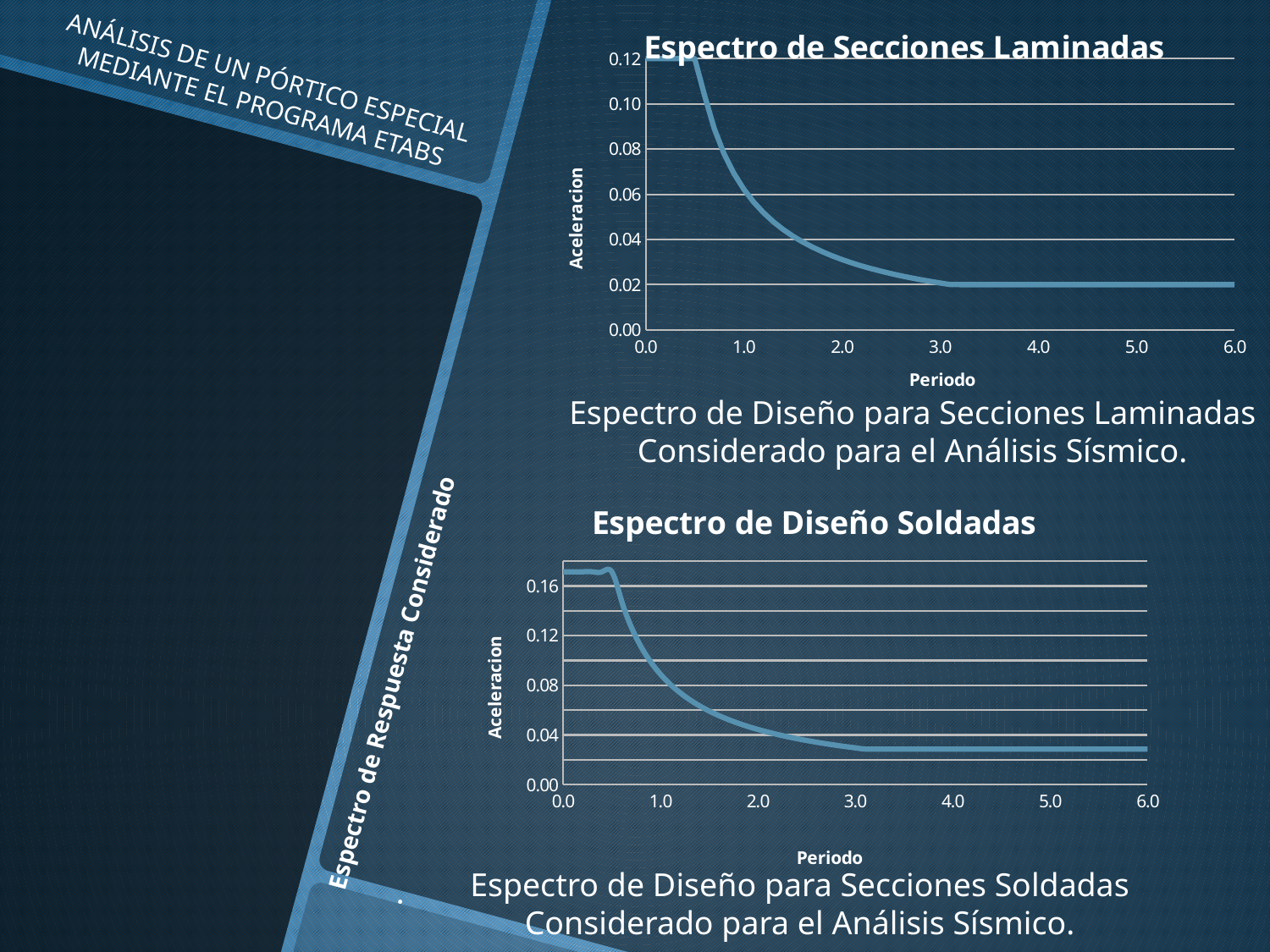
What is the label of the vertical axis in the 'Espectro de Secciones Laminadas' chart? Aceleracion In the 'Espectro de Diseño Soldadas' chart, does the acceleration rise or fall as the period increases from 0.5 to 3.0? fall In the 'Espectro de Secciones Laminadas' chart, is the acceleration at period 0.0 greater or less than 0.10? greater In the 'Espectro de Diseño Soldadas' chart, is the acceleration at period 5.0 greater or less than 0.04? less How many charts are shown on the slide? 2 In the 'Espectro de Secciones Laminadas' chart, is the acceleration at period 1.0 greater or less than 0.08? less What kind of chart is the 'Espectro de Diseño Soldadas' chart? line chart What is the label of the horizontal axis in the 'Espectro de Diseño Soldadas' chart? Periodo What kind of chart is the 'Espectro de Secciones Laminadas' chart? line chart In the 'Espectro de Secciones Laminadas' chart, does the acceleration rise or fall as the period increases from 0.5 to 3.0? fall